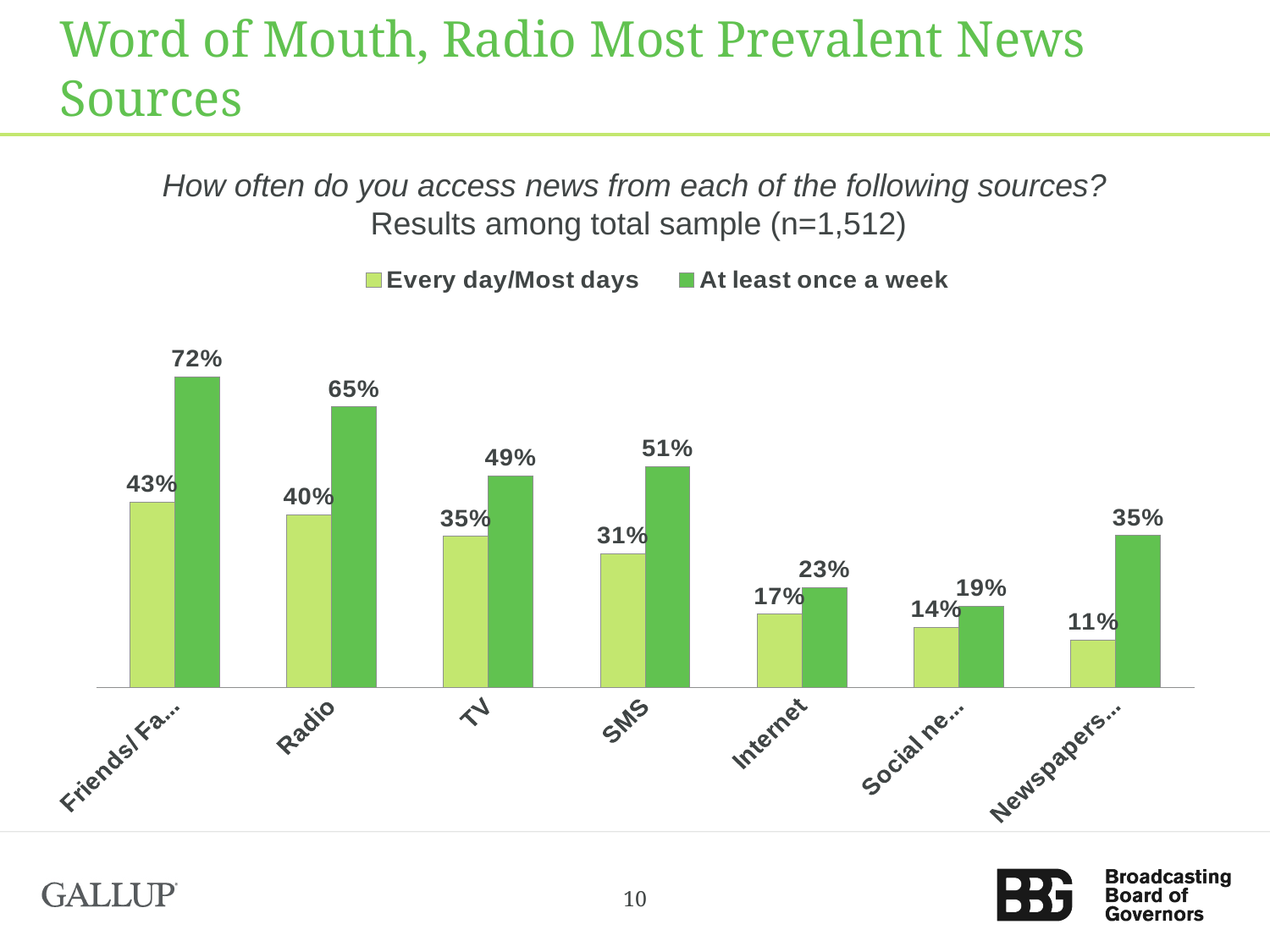
What is the difference between the 'At least once a week' values for Newspapers and Internet? 12% How many series does the legend list? 2 Which series is shown in the darker green colour? At least once a week What percentage access news from Radio every day/most days? 40% What is the 'At least once a week' value for SMS? 51% How many news sources (categories) are shown on the x axis? 7 Which is larger: the 'Every day/Most days' value for TV or for SMS? TV What percentage access news from TV at least once a week? 49% What type of chart is shown on the slide? bar chart Which news source has the lowest 'Every day/Most days' value? Newspapers What is the 'Every day/Most days' value for Internet? 17% What is the difference between the 'At least once a week' and 'Every day/Most days' values for Radio? 25%